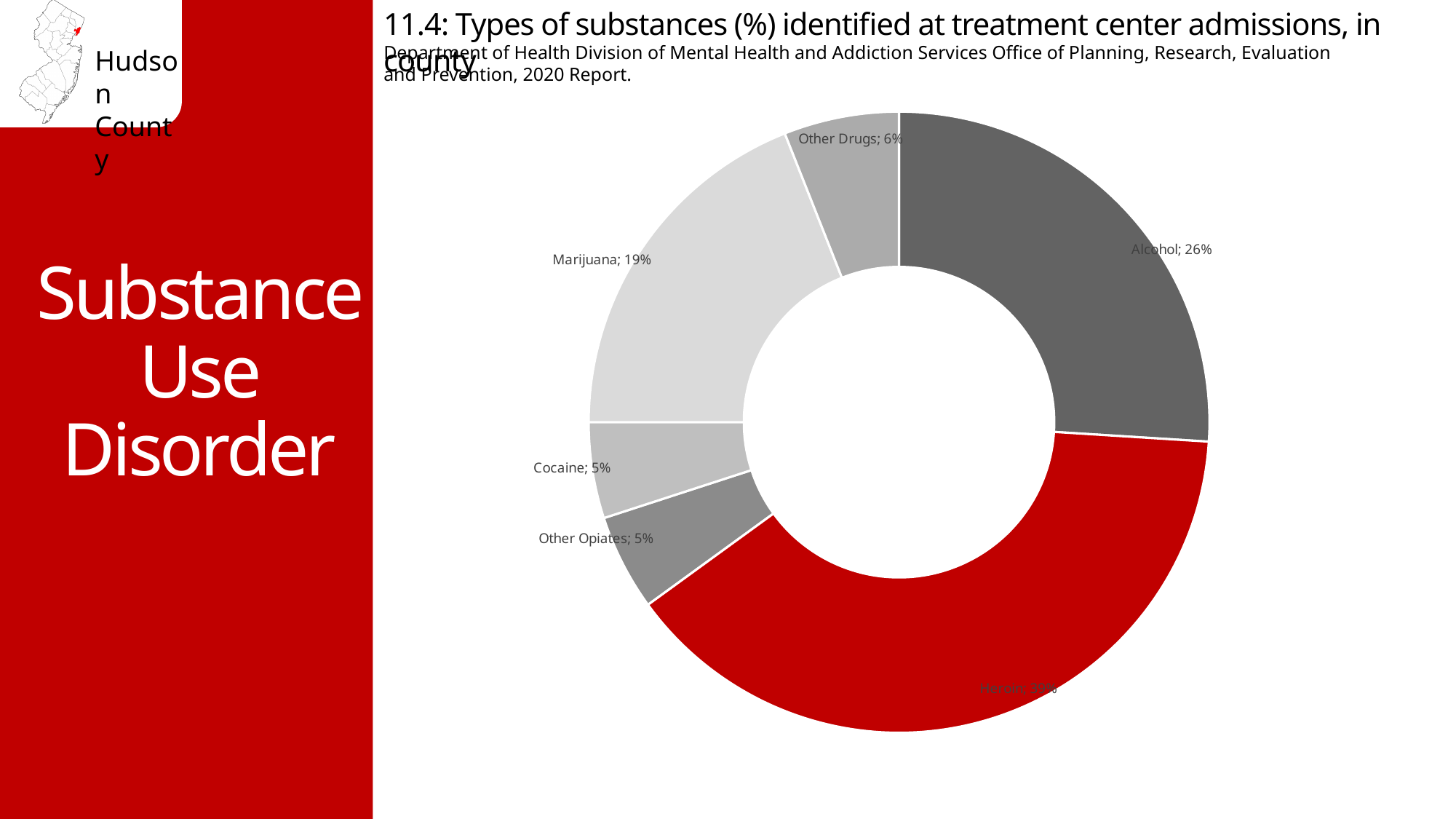
What percentage of treatment center admissions is attributed to Heroin? 39% Which substance accounts for the largest share of treatment center admissions? Heroin Which slice of the chart is coloured red? Heroin What kind of chart is shown on the slide? Doughnut (pie) chart What percentage of treatment center admissions is attributed to Alcohol? 26% What percentage of treatment center admissions is attributed to Other Drugs? 6% What percentage of treatment center admissions is attributed to Marijuana? 19% How many substance categories are shown in the chart? 6 What percentage of treatment center admissions is attributed to Cocaine? 5% Which is larger, the share for Alcohol or the share for Marijuana? Alcohol What is the difference in percentage points between Alcohol and Marijuana? 7 What is the difference in percentage points between Heroin and Alcohol? 13